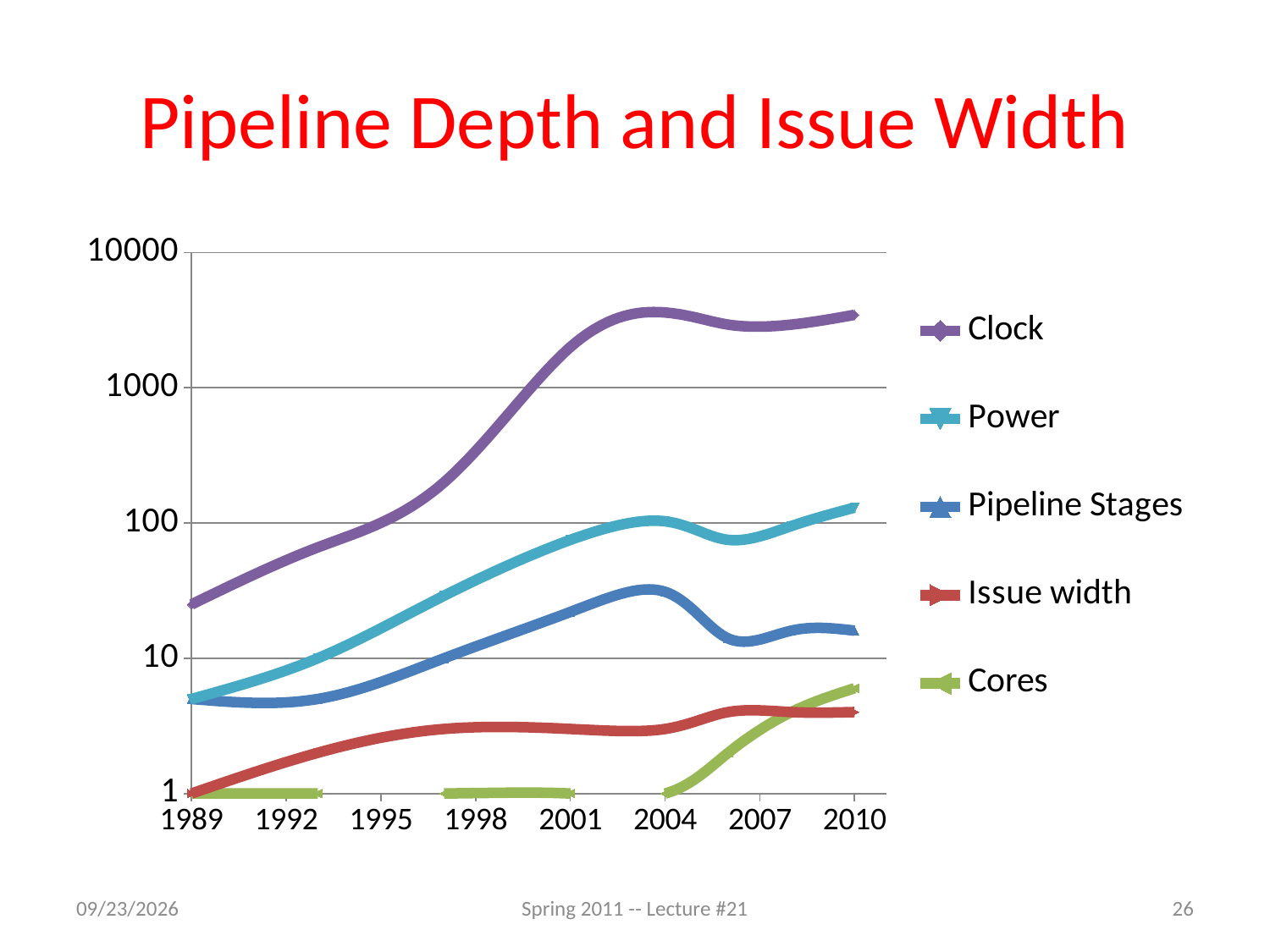
What is the value for Cores in 1989? 1 Which series has the highest value in 2010? Clock Is the value for Clock in 2010 greater or less than 1000? greater Is the value for Pipeline Stages in 2010 greater or less than 10? greater Is the value for Clock in 1989 greater or less than 10? greater What kind of chart is shown on the slide? line chart Which series has the lowest value in 2010? Issue width Does the Clock series rise or fall from 1989 to 2004? rise What is the title of the slide containing the chart? Pipeline Depth and Issue Width In 2004, which is larger: Pipeline Stages or Issue width? Pipeline Stages How many series does the legend list? 5 Which series is shown in purple in the legend? Clock